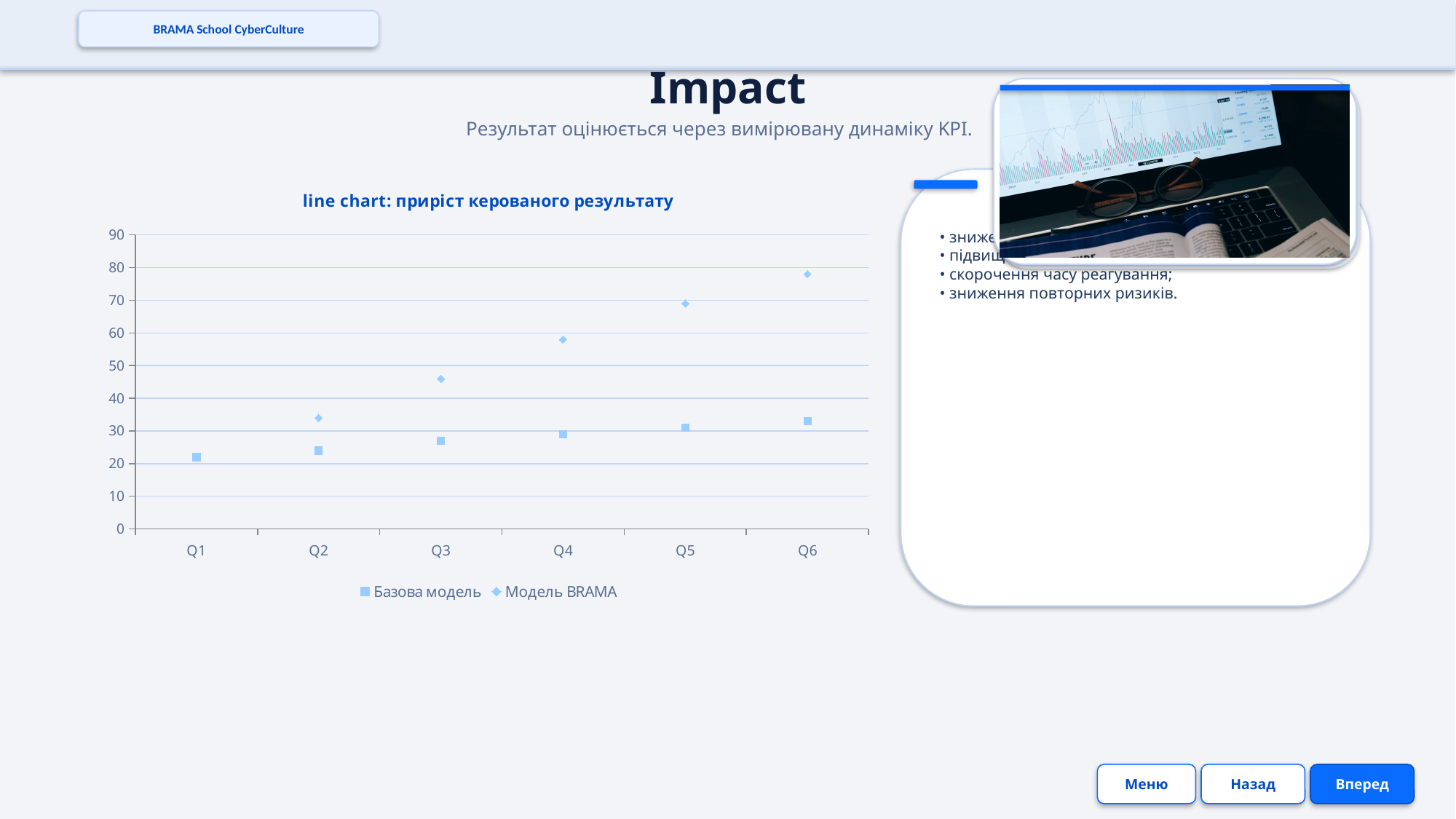
At which quarter does Модель BRAMA reach its highest value? Q6 Is the value for Модель BRAMA at Q4 greater or less than 50? greater Is the value for Базова модель at Q3 greater or less than 30? less How many series does the legend list? 2 Do the values for Модель BRAMA rise or fall from Q2 to Q6? rise At which quarter is Базова модель at its lowest value? Q1 Which series is shown with diamond markers in the legend? Модель BRAMA What is the title of the chart? line chart: приріст керованого результату At Q4, which series has the larger value, Базова модель or Модель BRAMA? Модель BRAMA Is the value for Модель BRAMA at Q3 greater or less than 50? less How many quarters are shown on the x axis? 6